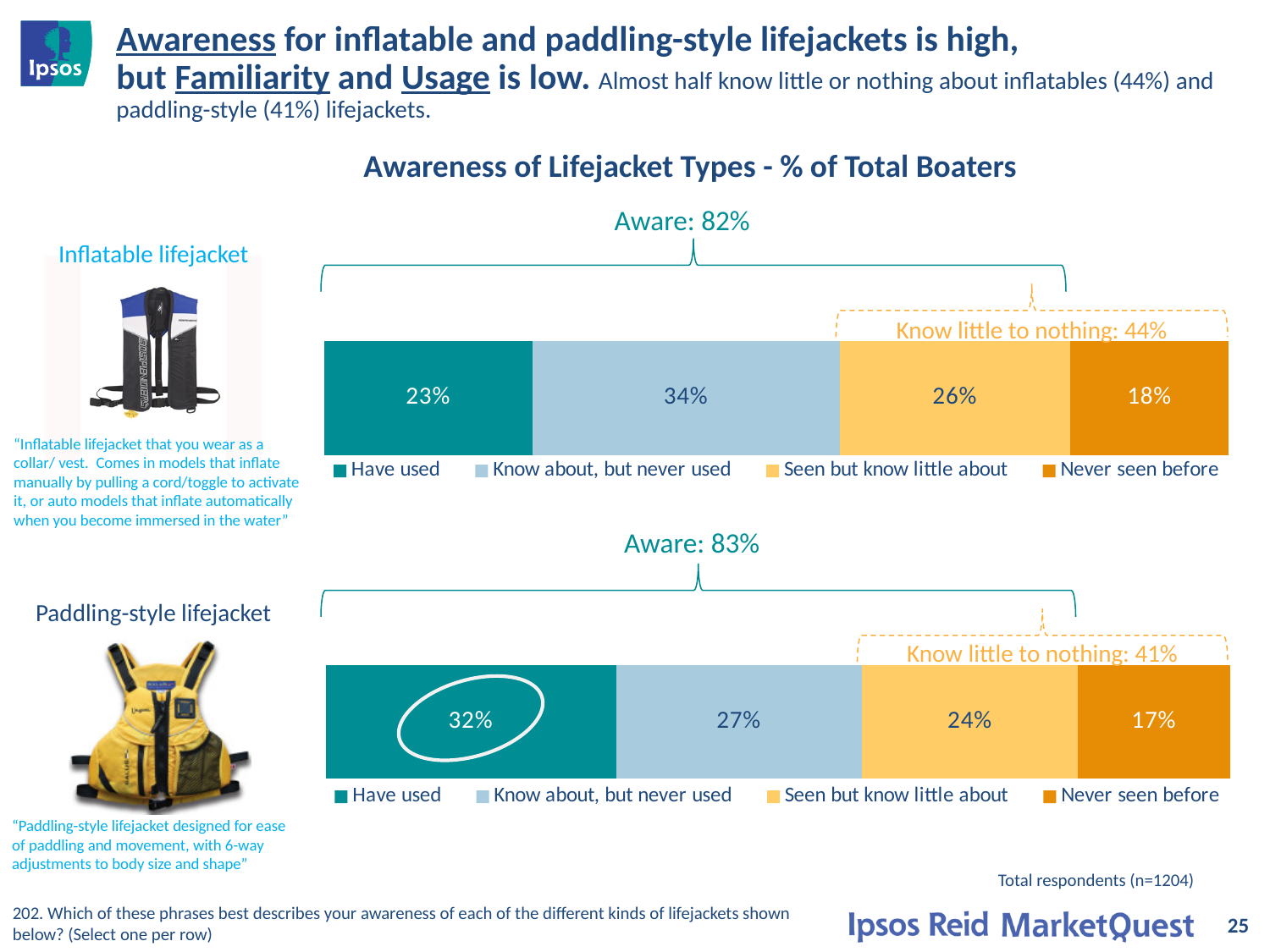
In the Paddling-style lifejacket chart, what percentage of boaters have never seen a paddling-style lifejacket before? 17% In the Paddling-style lifejacket chart, which category has the lowest value? Never seen before What kind of chart is used to show awareness of the Paddling-style lifejacket? Stacked bar chart Which is larger: 'Have used' for the Inflatable lifejacket or 'Have used' for the Paddling-style lifejacket? Paddling-style lifejacket In the Paddling-style lifejacket chart, what colour is the 'Have used' segment? Teal What is the title of the chart section on the slide? Awareness of Lifejacket Types - % of Total Boaters In the Inflatable lifejacket chart, what is the total of 'Have used' and 'Know about, but never used'? 57% In the Paddling-style lifejacket chart, what is the total of 'Seen but know little about' and 'Never seen before'? 41% In the Inflatable lifejacket chart, what percentage of boaters have used an inflatable lifejacket? 23% In the Inflatable lifejacket chart, what is the difference between 'Know about, but never used' and 'Have used'? 11% In the Inflatable lifejacket chart, which category has the highest value? Know about, but never used How many series does the legend list in the Inflatable lifejacket chart? 4